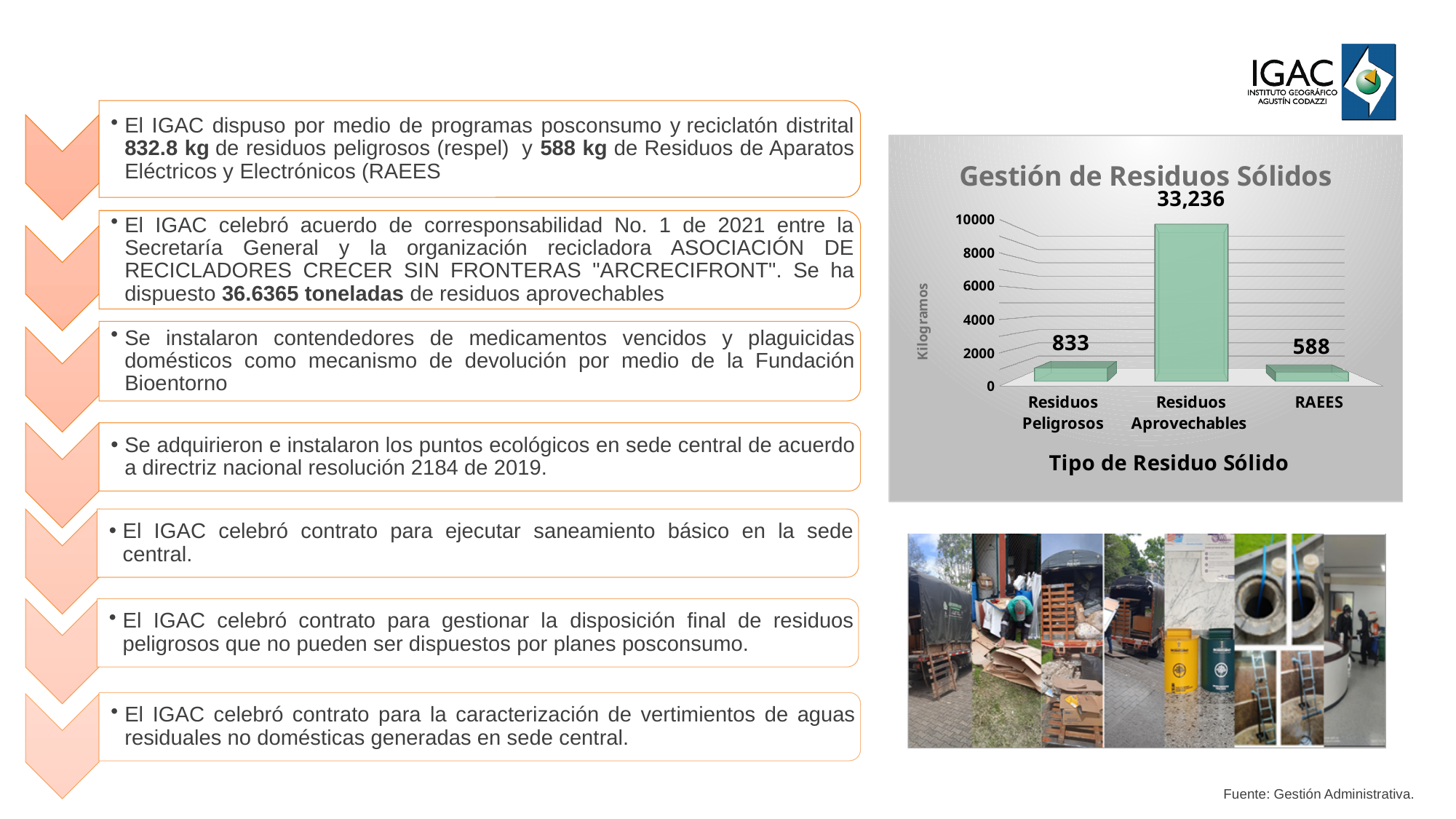
What is the value for RAEES in the chart? 588 What is the value for Residuos Aprovechables in the chart? 33,236 Which is larger, the value for Residuos Peligrosos or the value for RAEES? Residuos Peligrosos What is the difference between the values for Residuos Peligrosos and RAEES? 245 Which category has the highest value in the Gestión de Residuos Sólidos chart? Residuos Aprovechables Which category has the lowest value in the chart? RAEES What is the difference between the values for Residuos Aprovechables and Residuos Peligrosos? 32,403 What is the value for Residuos Peligrosos in the Gestión de Residuos Sólidos chart? 833 What kind of chart is shown on the slide? Bar chart Is the value for Residuos Aprovechables greater or less than 10000? greater How many categories are shown on the x axis of the chart? 3 What is the title of the chart on the slide? Gestión de Residuos Sólidos